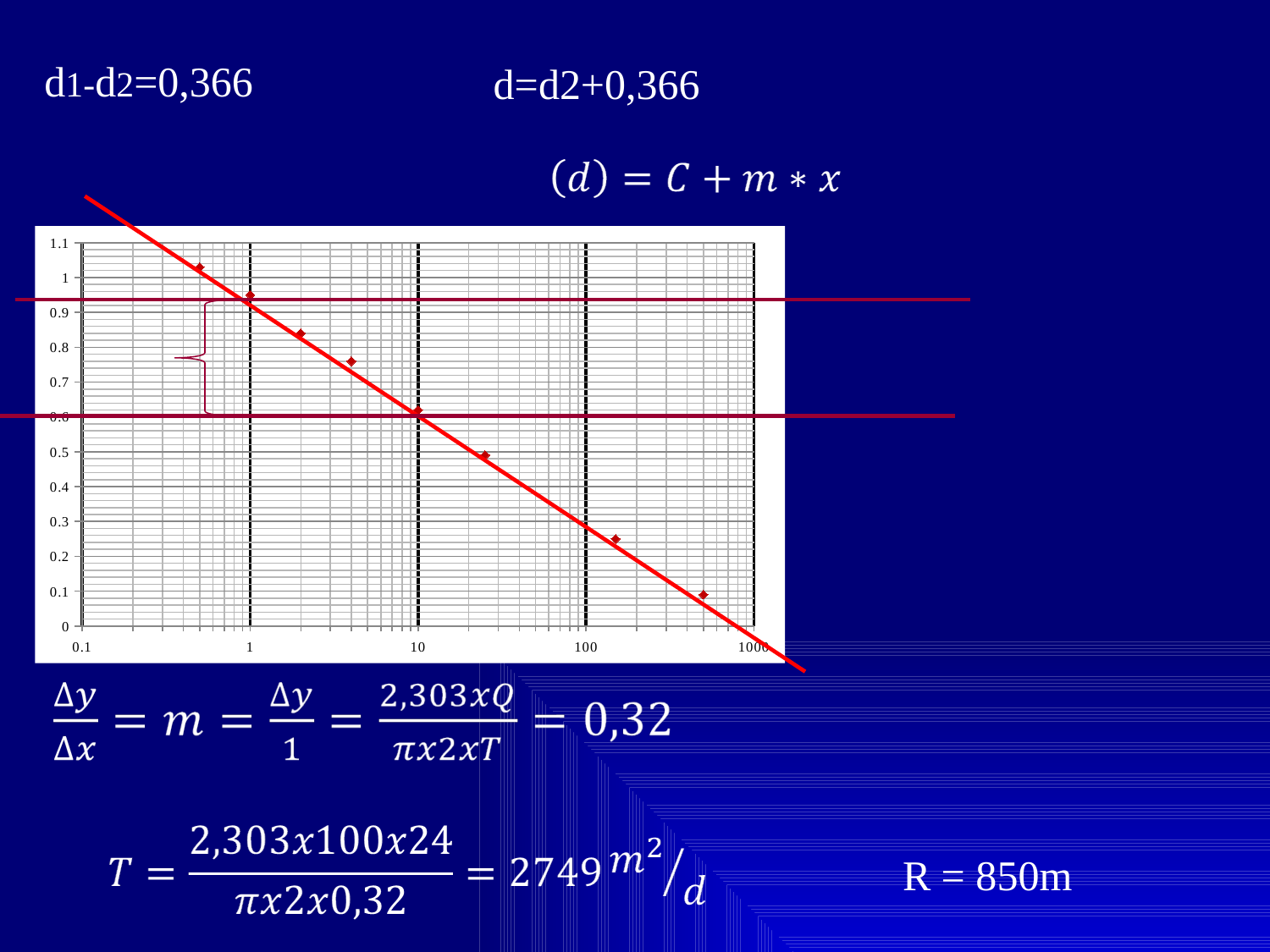
Is the y value of the point near x = 150 greater or less than 0.3? less Is the y value of the rightmost point (near x = 500) greater or less than 0.2? less Is the point with the highest y value at the left end or the right end of the x axis? left end What colour is the fitted straight line drawn through the points? red Which point has the higher y value: the one at x = 1 or the one at x = 10? the one at x = 1 What kind of chart is shown on the slide? scatter chart How many data points are plotted on the chart? 8 Do the plotted y values rise or fall as x increases along the x axis? fall Is the point with the lowest y value at the left end or the right end of the x axis? right end Is the y value of the point at x = 1 greater or less than 0.9? greater What is the highest tick value shown on the x axis? 1000